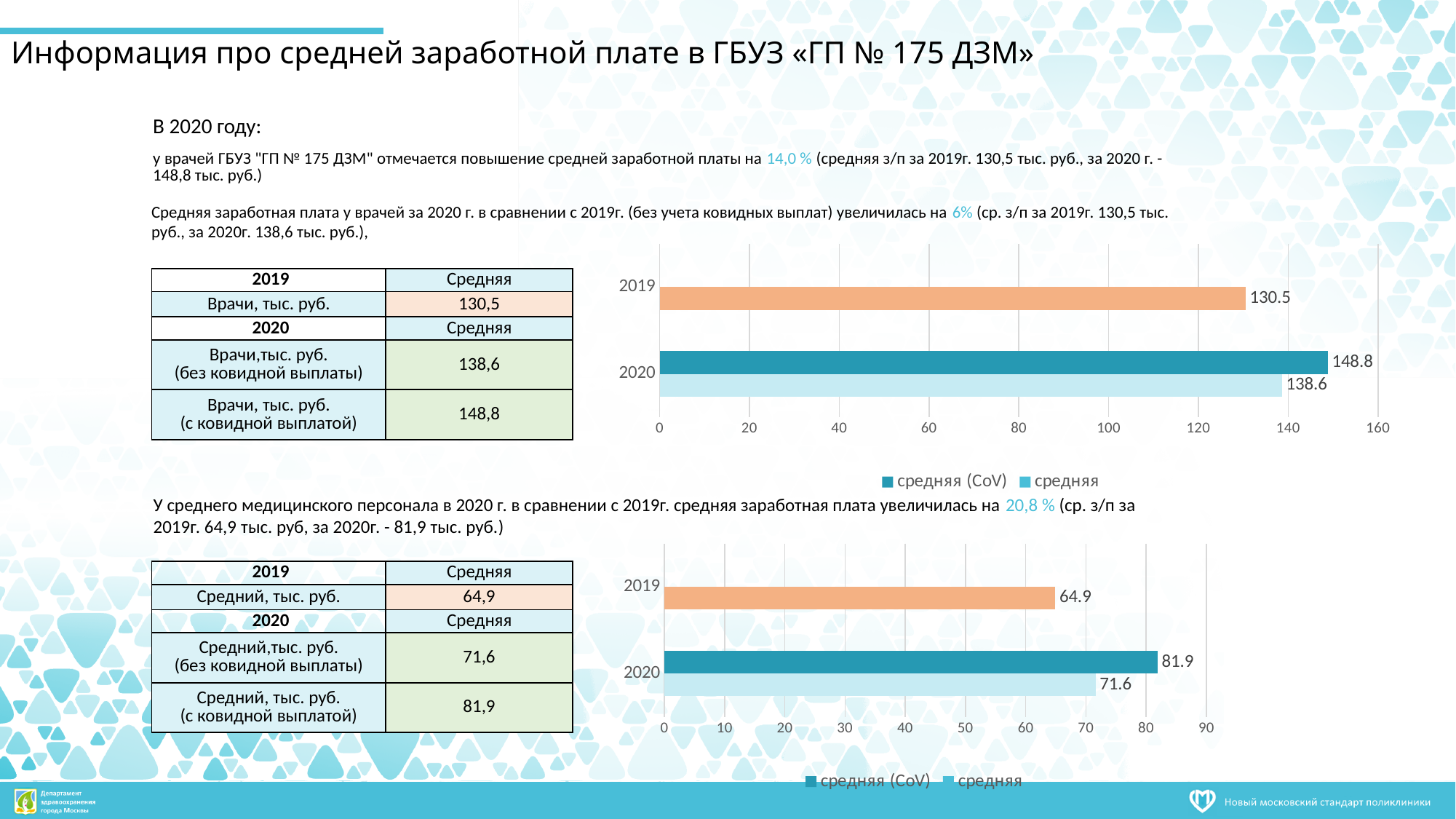
On the bottom chart, which is larger: the 2019 value or the 2020 'средняя' value? 2020 средняя How many series does the legend of the top chart list? 2 On the bottom chart, what is the value of the 'средняя' bar for 2020? 71.6 On the top chart, what is the value of the 'средняя (CoV)' bar for 2020? 148.8 On the top chart, what is the value of the 2019 bar? 130.5 On the bottom chart, what is the value of the 2019 bar? 64.9 On the top chart, what is the value of the 'средняя' bar for 2020? 138.6 On the bottom chart, what is the value of the 'средняя (CoV)' bar for 2020? 81.9 On the bottom chart, what is the difference between the 2020 'средняя (CoV)' value and the 2020 'средняя' value? 10.3 What kind of chart is the top chart? bar chart On the top chart, which bar has the highest value? 2020 средняя (CoV) On the top chart, what is the difference between the 2020 'средняя (CoV)' value and the 2019 value? 18.3